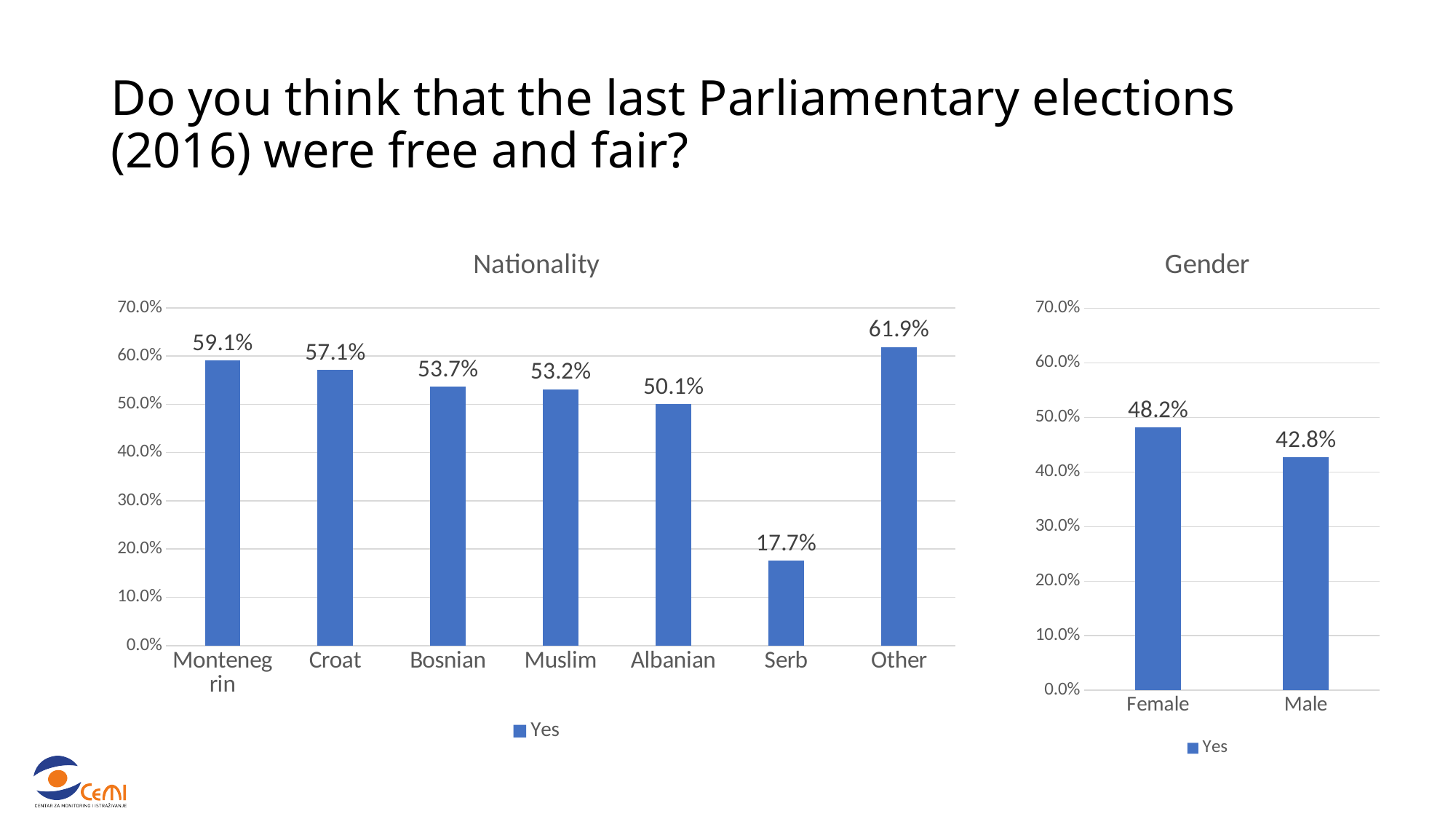
In the Gender chart, what is the difference between the Female and Male values? 5.4% What kind of chart is the Gender chart? bar chart In the Nationality chart, what is the value for Croat? 57.1% How many categories are shown in the Nationality chart? 7 In the Nationality chart, which is larger, the value for Bosnian or the value for Albanian? Bosnian In the Nationality chart, what is the difference between the Montenegrin and Albanian values? 9.0% How many series does the legend of the Gender chart list? 1 In the Nationality chart, is the value for Serb greater or less than 20.0%? less In the Nationality chart, which category has the lowest value? Serb In the Nationality chart, which category has the highest value? Other In the Nationality chart, what is the value for Serb? 17.7% In the Gender chart, what is the value for Male? 42.8%